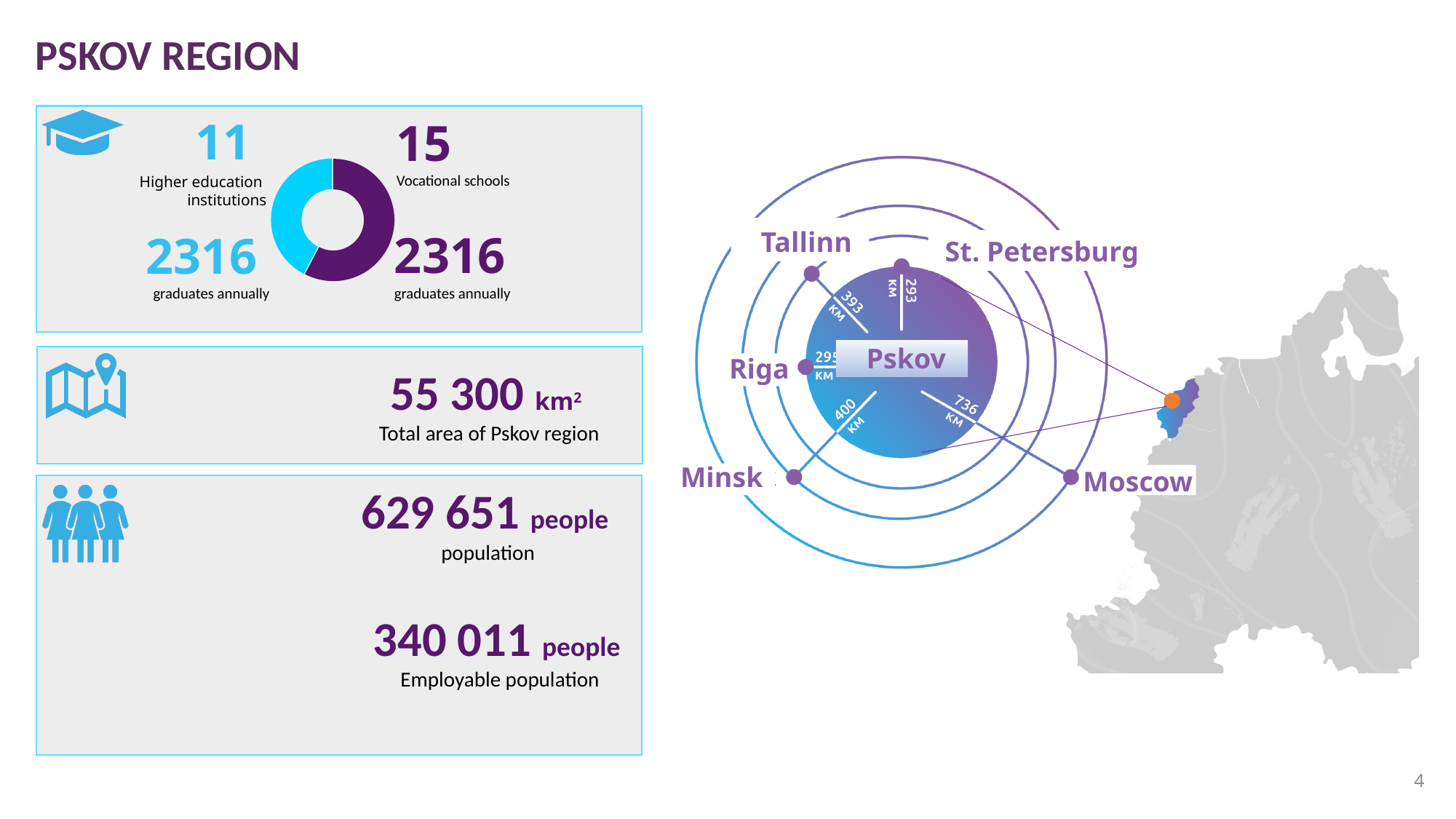
In the donut chart, what is the difference between the number of vocational schools and the number of higher education institutions? 4 In the donut chart, which colour represents higher education institutions? Cyan (light blue) In the donut chart, how many higher education institutions are shown? 11 In the distance diagram on the right, what is the distance from Pskov to Moscow? 736 km In the distance diagram on the right, which city is farthest from Pskov? Moscow In the donut chart, which colour represents vocational schools? Purple In the donut chart, how many vocational schools are shown? 15 What kind of chart is shown in the education box on the left of the slide? Pie chart (donut) In the donut chart, how many graduates annually are listed for higher education institutions? 2316 In the distance diagram on the right, how many cities are shown around Pskov? 5 How many categories does the donut chart in the education box show? 2 In the donut chart, which category has the larger number of institutions: higher education institutions or vocational schools? Vocational schools